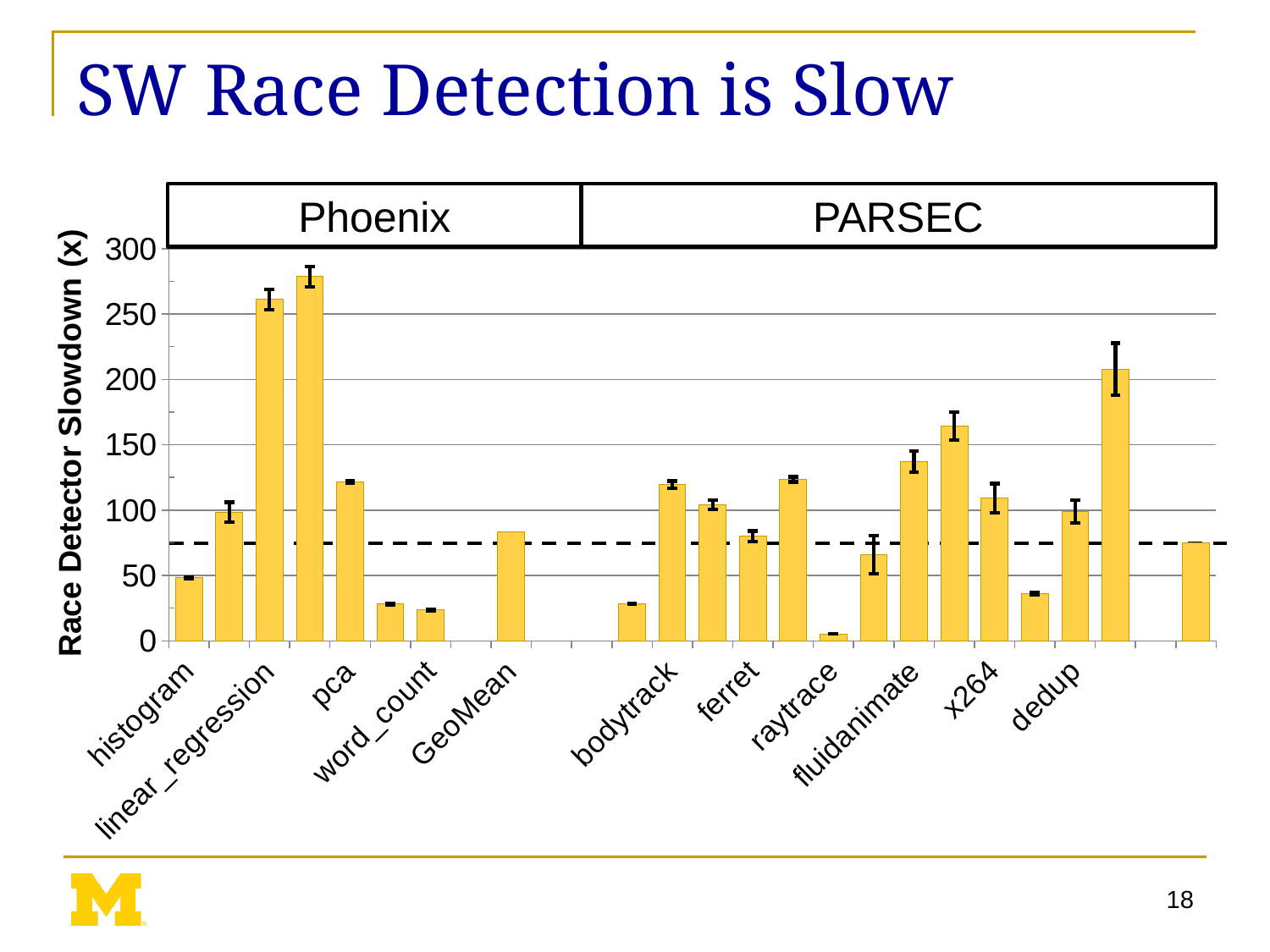
Is the value for linear_regression greater or less than 250? greater Which has the larger slowdown, raytrace or fluidanimate? fluidanimate Is the value for raytrace greater or less than 50? less What is the label of the vertical axis? Race Detector Slowdown (x) Is the value for ferret greater or less than 100? less What kind of chart is shown on the slide? bar chart Which has the larger slowdown, linear_regression or histogram? linear_regression What are the two benchmark suite groups labeled above the chart? Phoenix and PARSEC